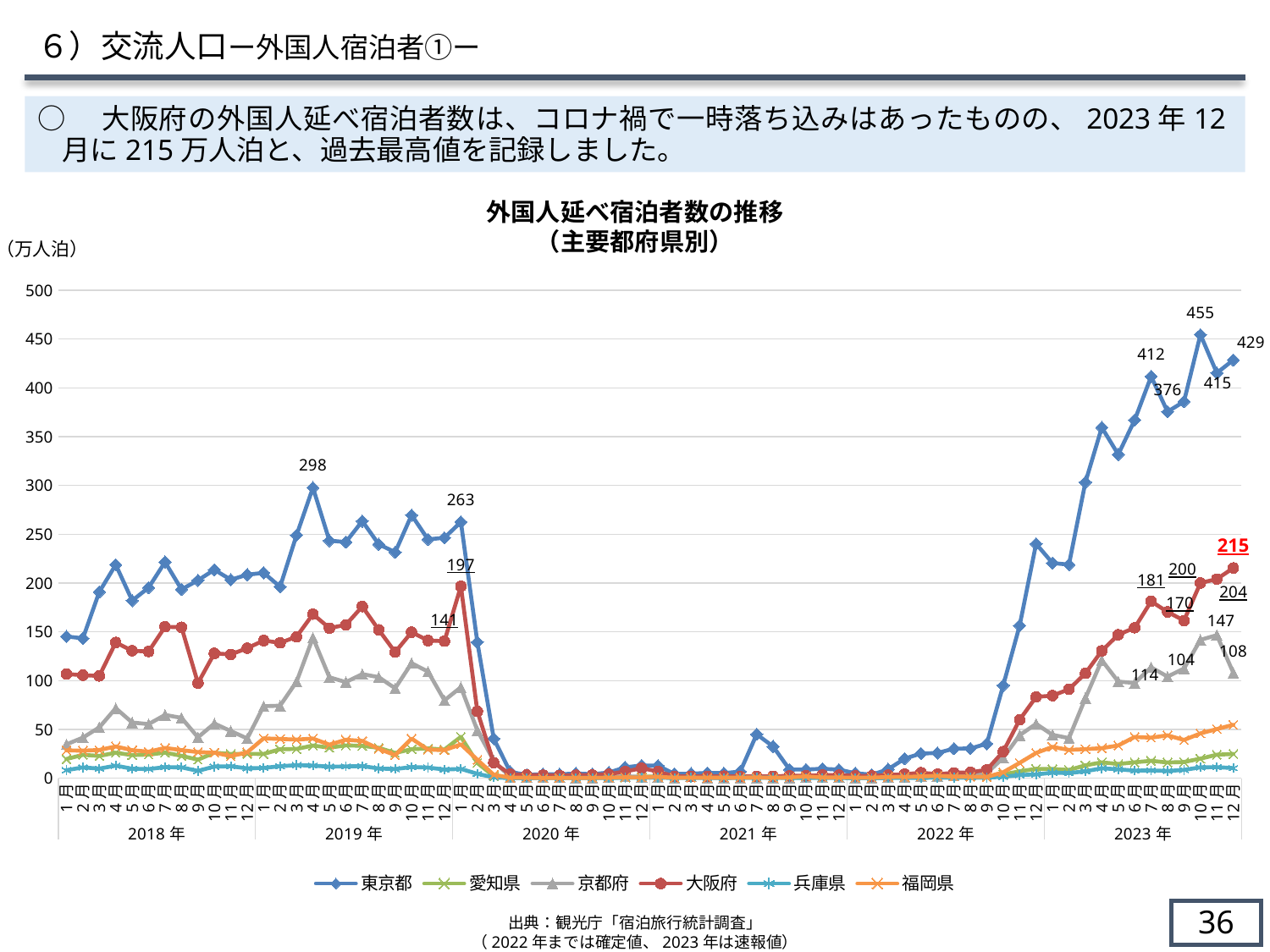
What is the title of the chart? 外国人延べ宿泊者数の推移（主要都府県別） How many series does the legend list? 6 What kind of chart is shown on the slide? line chart What is the value for 東京都 in April 2019? 298 Which series has the highest value in December 2023? 東京都 What is the value for 東京都 in October 2023? 455 What is the difference between 東京都 and 大阪府 in December 2023? 214 Which is larger in December 2023, 東京都 or 京都府? 東京都 What is the value for 京都府 in December 2023? 108 Is the value for 東京都 in December 2022 greater or less than 200? greater What is the value for 大阪府 in December 2023? 215 What is the value for 大阪府 in January 2020? 197